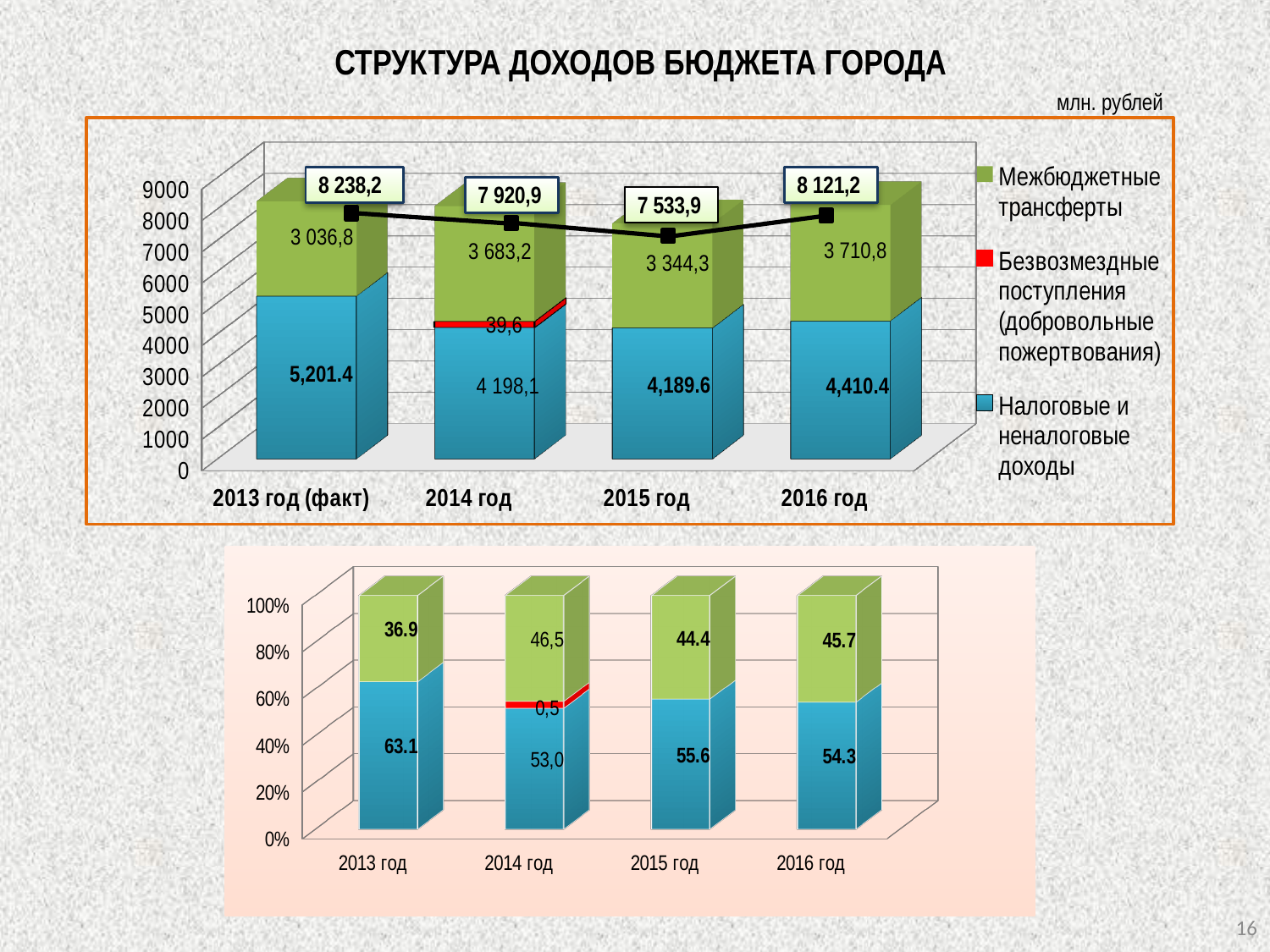
In the top chart, which year has the lowest value of Межбюджетные трансферты? 2013 год (факт) In the top chart, what is the value of Безвозмездные поступления (добровольные пожертвования) for 2014 год? 39,6 In the bottom chart, what is the share of Налоговые и неналоговые доходы for 2014 год? 53,0 What kind of chart is the bottom chart? Stacked bar chart In the top chart, what is the value of Межбюджетные трансферты for 2016 год? 3 710,8 In the bottom chart, which year has the highest share of Межбюджетные трансферты? 2014 год How many series does the legend of the top chart list? 3 In the top chart, what is the value of Налоговые и неналоговые доходы for 2013 год (факт)? 5,201.4 In the top chart, what total is shown above the bar for 2015 год? 7 533,9 In the top chart, which year has the highest total shown on the line? 2013 год (факт) In the top chart, is the value of Налоговые и неналоговые доходы larger for 2015 год or 2016 год? 2016 год What unit is stated above the top chart? млн. рублей